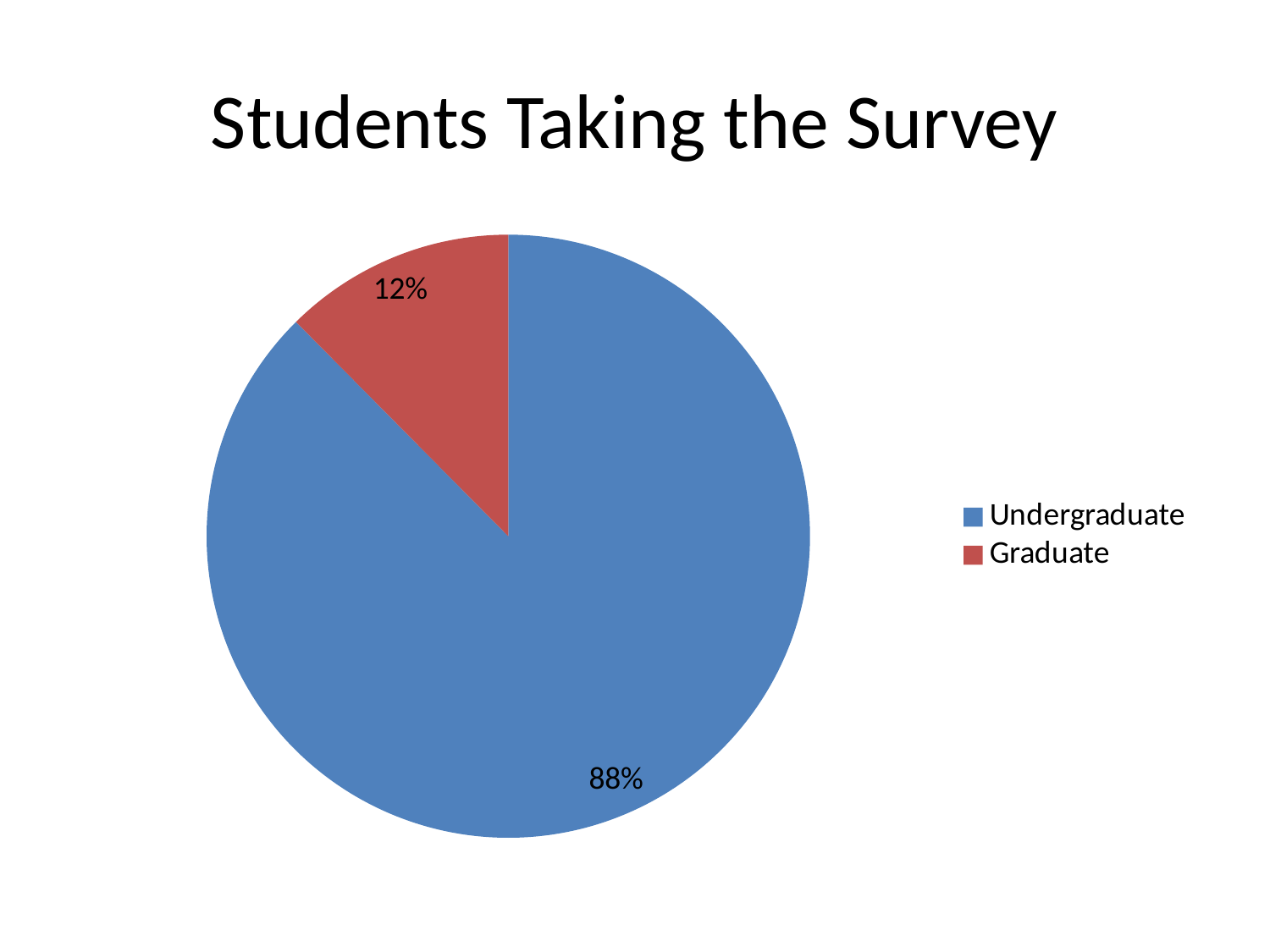
What colour is the Graduate slice? red Which category has the largest slice? Undergraduate What share of the pie is Graduate? 12% How many categories does the pie chart show? 2 What share of the pie is Undergraduate? 88% Which category has the smallest slice? Graduate What is the difference in percentage points between the Undergraduate and Graduate slices? 76 What is the title of the chart? Students Taking the Survey How many entries does the legend list? 2 Which is larger, the Graduate slice or the Undergraduate slice? Undergraduate What kind of chart is shown on the slide? pie chart